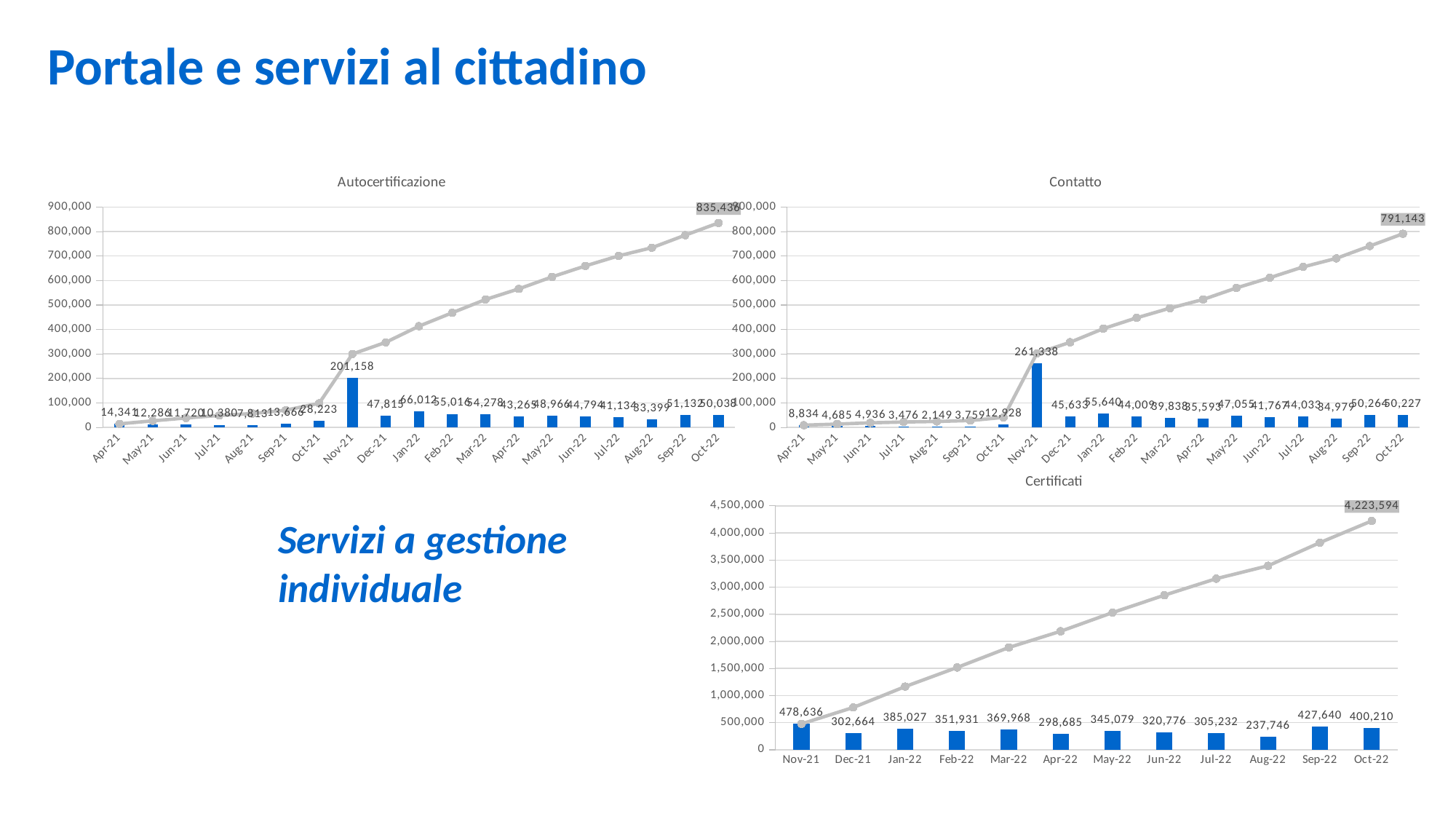
In the Certificati chart, what is the final value labelled on the cumulative line at Oct-22? 4,223,594 In the Autocertificazione chart, what is the final value labelled on the cumulative line at Oct-22? 835,436 Which chart has the larger Nov-21 bar, Autocertificazione or Contatto? Contatto In the Certificati chart, which month has the highest bar? Nov-21 In the Certificati chart, how many months are shown on the x axis? 12 In the Certificati chart, is the cumulative line value at Apr-22 greater or less than 2,000,000? greater In the Contatto chart, what is the value of the bar for Nov-21? 261,338 In the Certificati chart, what is the value of the bar for Nov-21? 478,636 What kind of chart is the Certificati chart? A bar chart combined with a line In the Certificati chart, which month has the lowest bar? Aug-22 In the Certificati chart, what is the difference between the bars for Sep-22 and Aug-22? 189,894 In the Autocertificazione chart, what is the value of the bar for Nov-21? 201,158